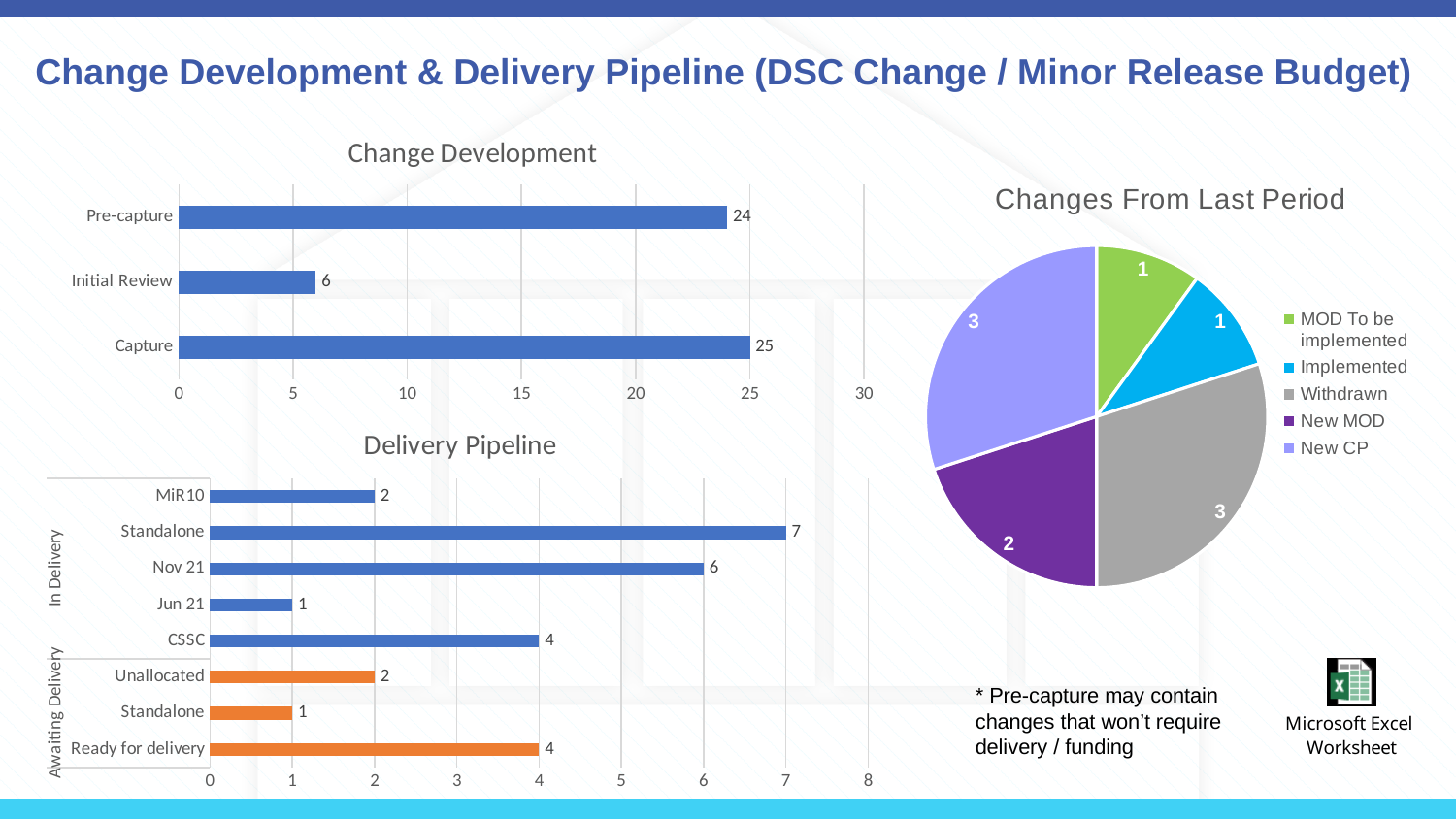
What kind of chart is the Delivery Pipeline chart? Bar chart In the Delivery Pipeline chart, what is the value for Nov 21? 6 In the Delivery Pipeline chart, which is larger, CSSC or Unallocated? CSSC In the Delivery Pipeline chart, which category has the highest value? Standalone (In Delivery) In the Change Development chart, what is the value for Pre-capture? 24 In the Change Development chart, how many categories are shown? 3 In the Change Development chart, which category has the lowest value? Initial Review In the Delivery Pipeline chart, how many categories are shown? 8 In the Change Development chart, what is the difference between Capture and Initial Review? 19 In the Changes From Last Period pie chart, what share of the total does Withdrawn represent? 30% In the Changes From Last Period pie chart, what is the value for New MOD? 2 How many entries does the legend of the Changes From Last Period pie chart list? 5